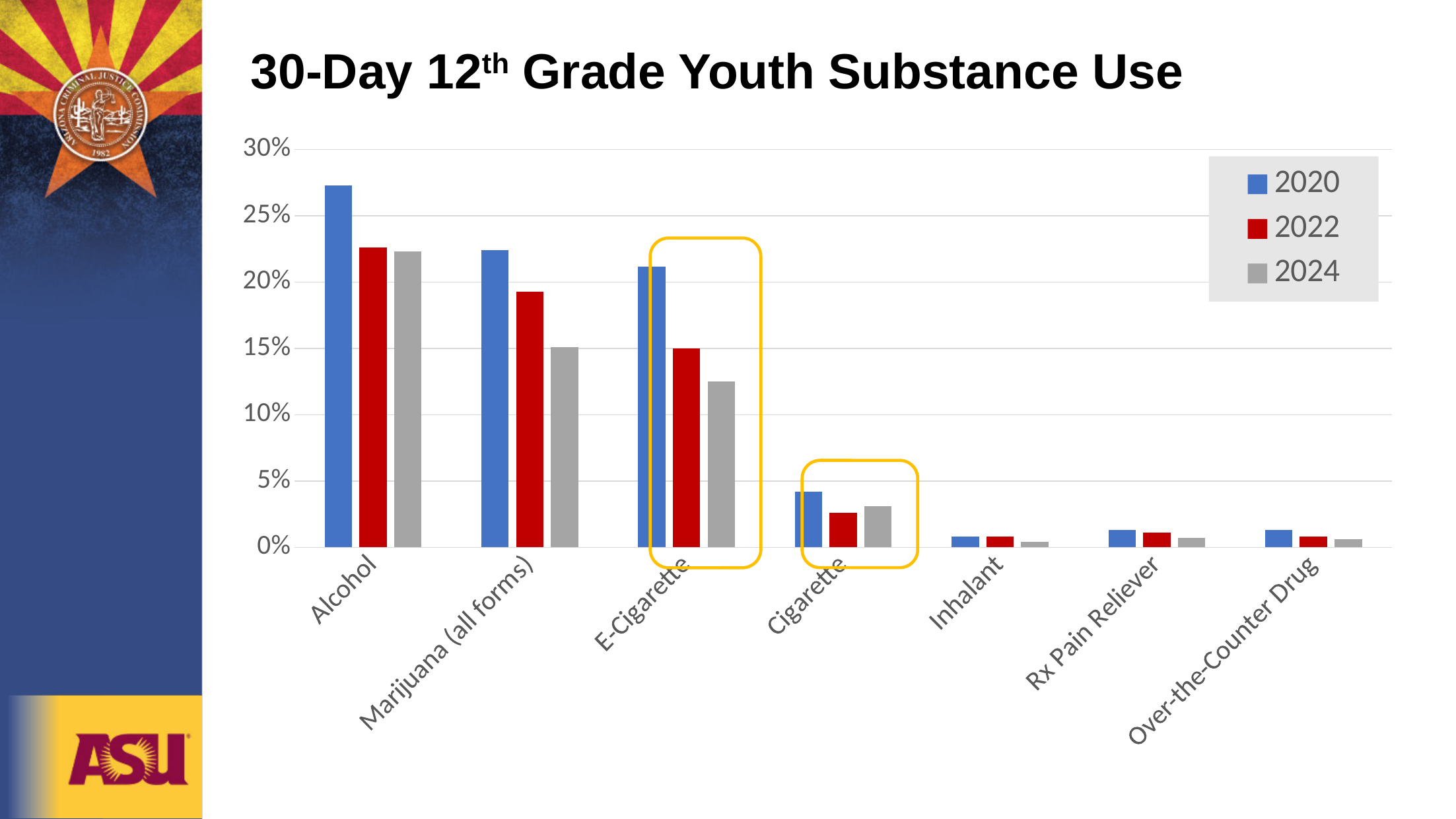
Which substance has the highest 2020 value? Alcohol Which is larger for 2022: Marijuana (all forms) or E-Cigarette? Marijuana (all forms) Is the 2020 value for Alcohol greater or less than 25%? greater Do the E-Cigarette values rise or fall from 2020 to 2024? Fall What kind of chart is shown on the slide? Bar chart Which substance has the lowest 2020 value? Inhalant Is the 2024 value for Marijuana (all forms) greater or less than 20%? less Is the 2020 value for Cigarette greater or less than 5%? less Which two categories are highlighted with yellow boxes on the chart? E-Cigarette and Cigarette How many series does the legend list? 3 How many substance categories are shown on the x axis? 7